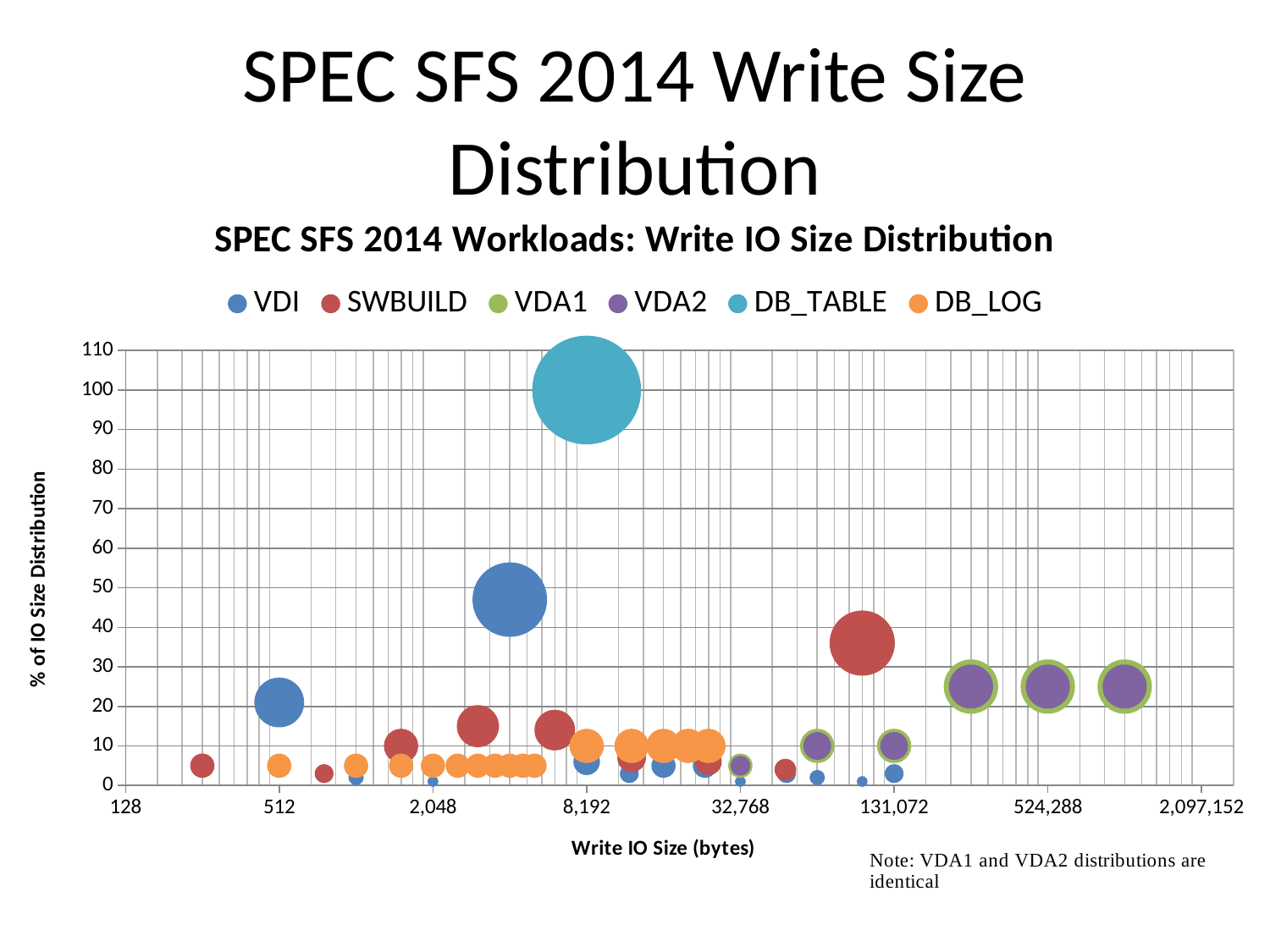
What kind of chart is shown on the slide? bubble chart What is the x-axis title of the chart? Write IO Size (bytes) What is the title of the chart? SPEC SFS 2014 Workloads: Write IO Size Distribution Is the value for VDA2 at 524,288 bytes greater or less than 20? greater What is the % of IO Size Distribution value for DB_TABLE at a write IO size of 8,192 bytes? 100 Which series has the highest % of IO Size Distribution value on the chart? DB_TABLE Is the value for DB_TABLE at 8,192 bytes greater or less than 90? greater Is the highest value for VDI greater or less than 40? greater Which is larger: the highest value for DB_TABLE or the highest value for VDI? DB_TABLE Which is larger: the highest value for VDI or the highest value for SWBUILD? VDI How many series does the legend list? 6